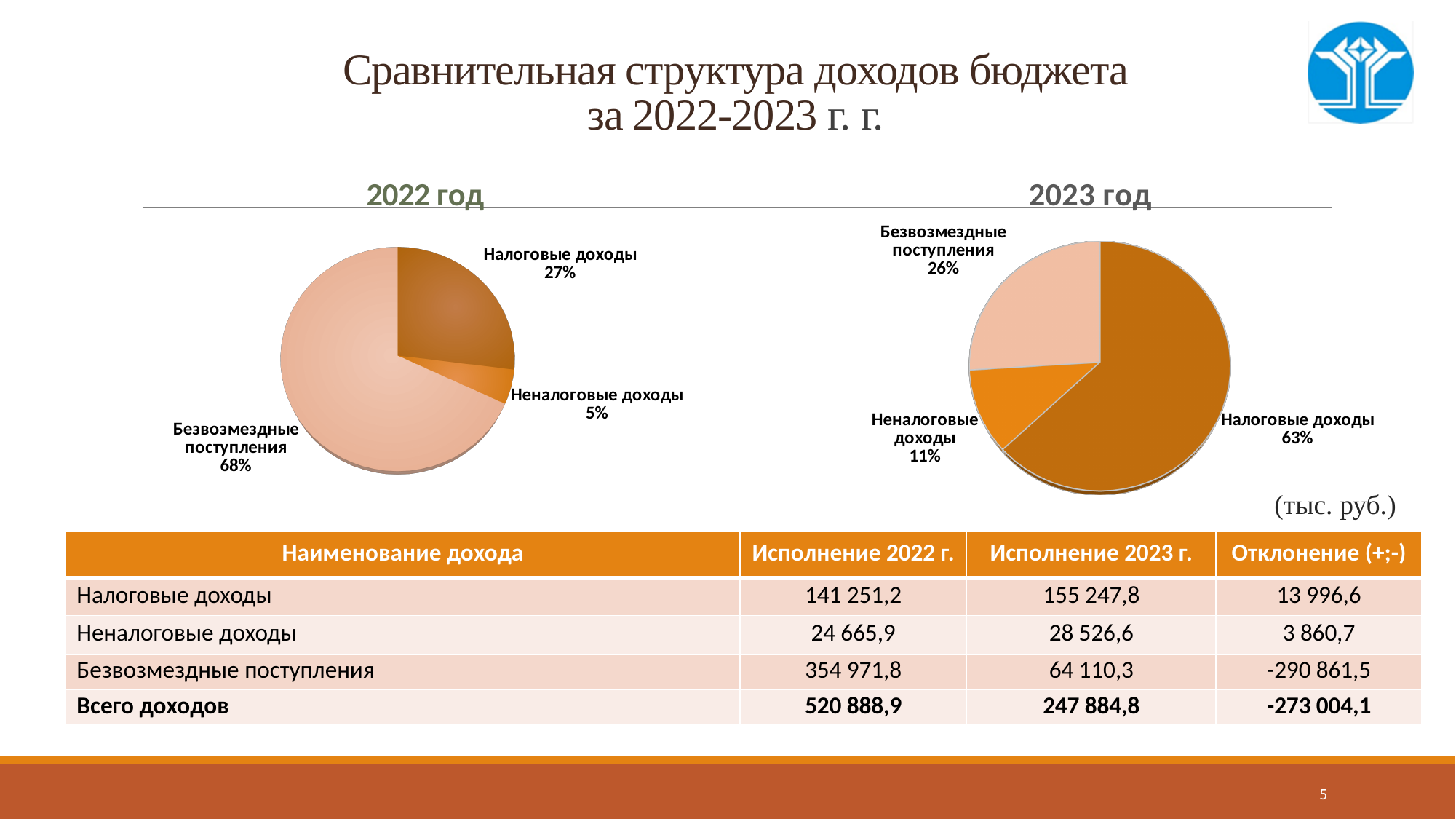
In the "2023 год" pie chart, what share does "Налоговые доходы" have? 63% In the "2023 год" pie chart, which category has the smallest slice? Неналоговые доходы In the "2023 год" pie chart, what share does "Неналоговые доходы" have? 11% In the "2022 год" pie chart, which category has the largest slice? Безвозмездные поступления In the "2023 год" pie chart, which is larger: "Налоговые доходы" or "Безвозмездные поступления"? Налоговые доходы What type of chart is used for "2022 год"? Pie chart How many slices does the "2023 год" pie chart have? 3 In the "2022 год" pie chart, what share does "Неналоговые доходы" have? 5% In the "2022 год" pie chart, what is the difference in percentage points between "Безвозмездные поступления" and "Налоговые доходы"? 41